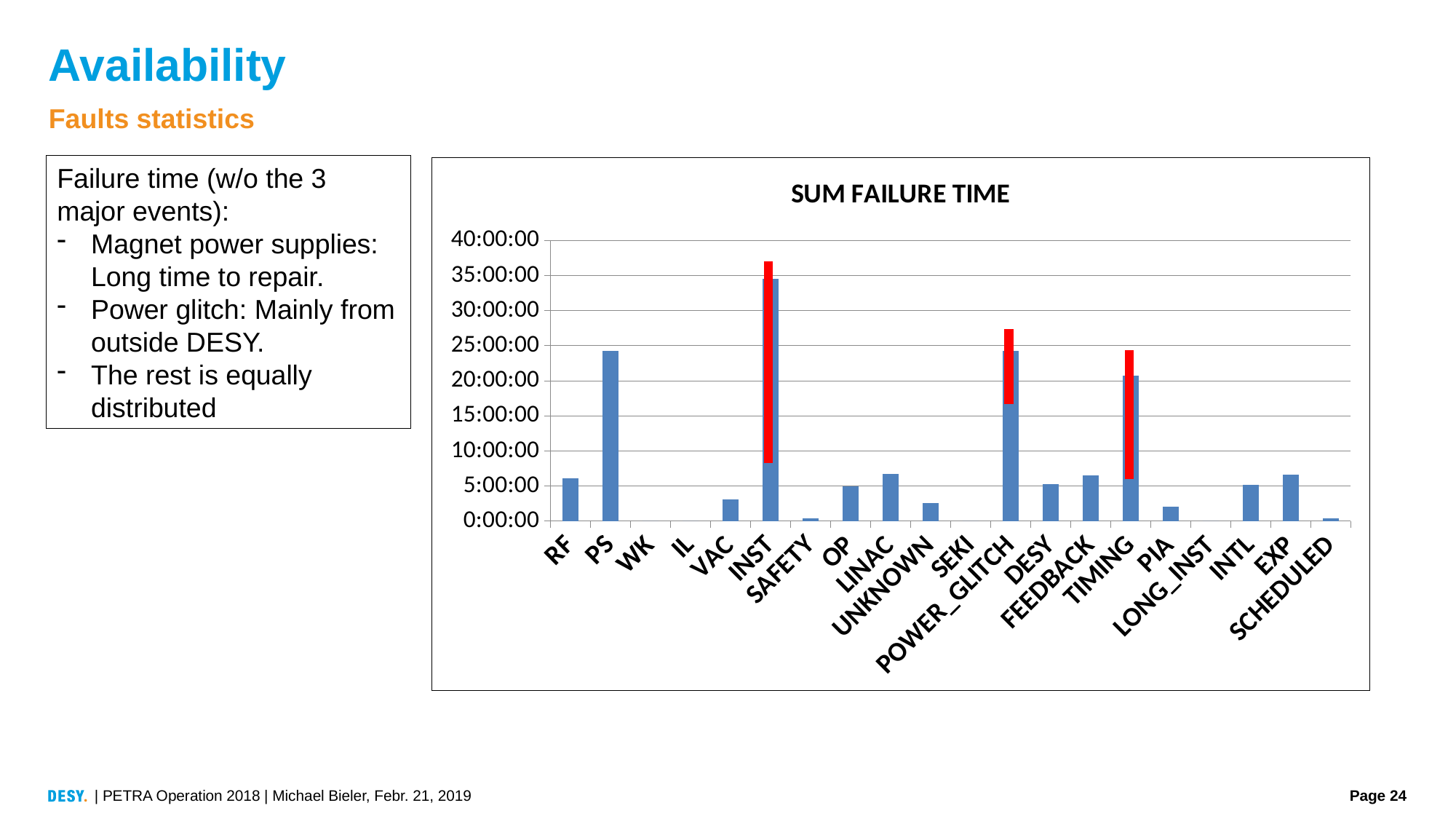
What is the title of the chart? SUM FAILURE TIME Is the value for INST greater or less than 30:00:00? greater Is the value for PS greater or less than 20:00:00? greater Which has a larger sum failure time, PS or RF? PS Is the value for POWER_GLITCH greater or less than 20:00:00? greater Which has a larger sum failure time, INST or POWER_GLITCH? INST Which three categories have red markings on their bars? INST, POWER_GLITCH, TIMING Which category has the highest sum failure time? INST What kind of chart is shown on the slide? bar chart How many categories are shown on the x axis of the chart? 20